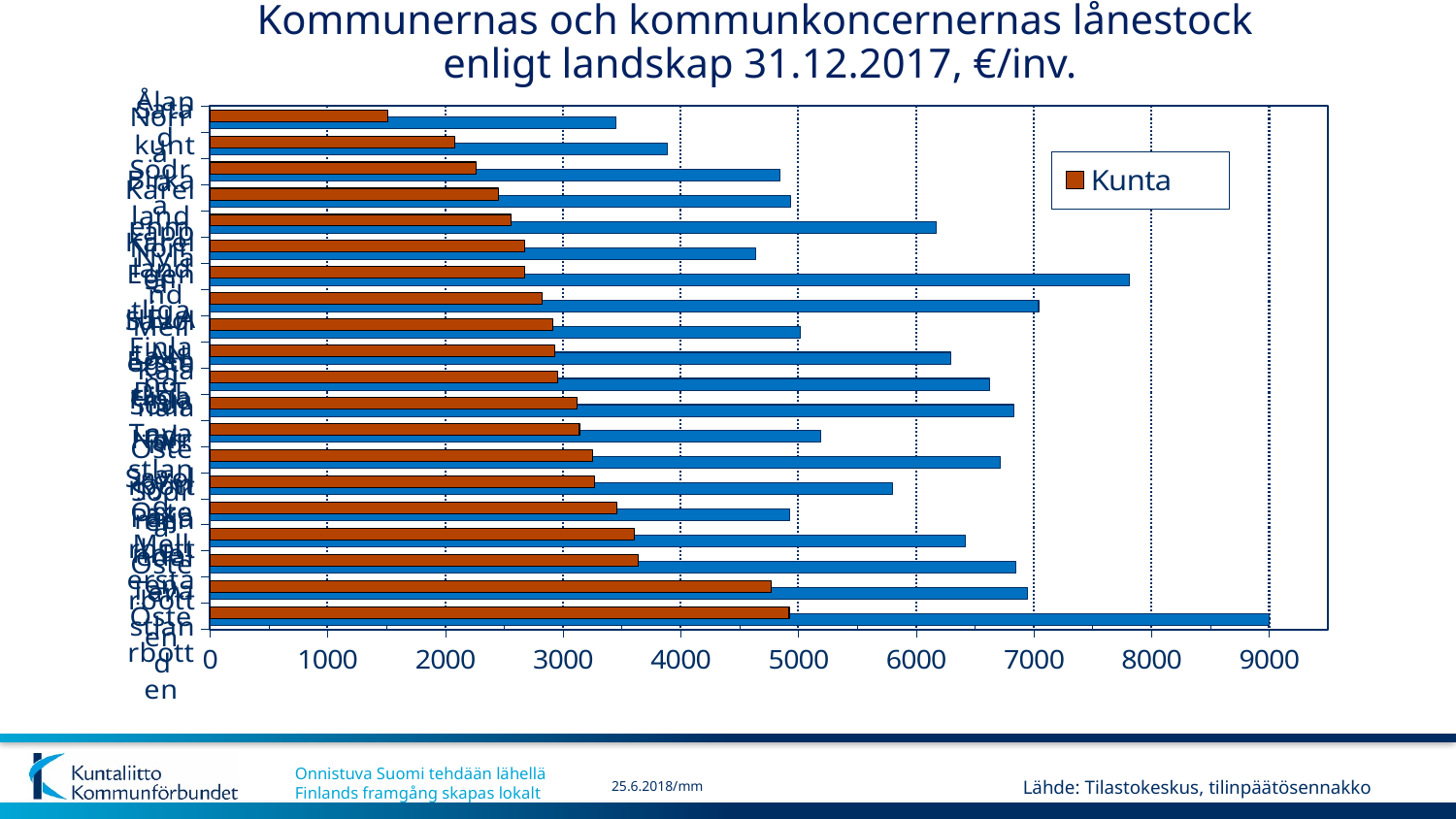
What kind of chart is shown on the slide? bar chart In the top row, which bar is longer, the orange one or the blue one? the blue one Is the value of the orange bar in the top row greater or less than 2000? less Is the value of the longest blue bar (the bottom row) greater or less than 8000? greater In the bottom row, which bar is longer, the orange one or the blue one? the blue one Is the value of the orange bar in the bottom row greater or less than 4000? greater What is the title of the chart? Kommunernas och kommunkoncernernas lånestock enligt landskap 31.12.2017, €/inv. What is the highest value shown on the x axis? 9000 Which series name is shown in the chart legend? Kunta